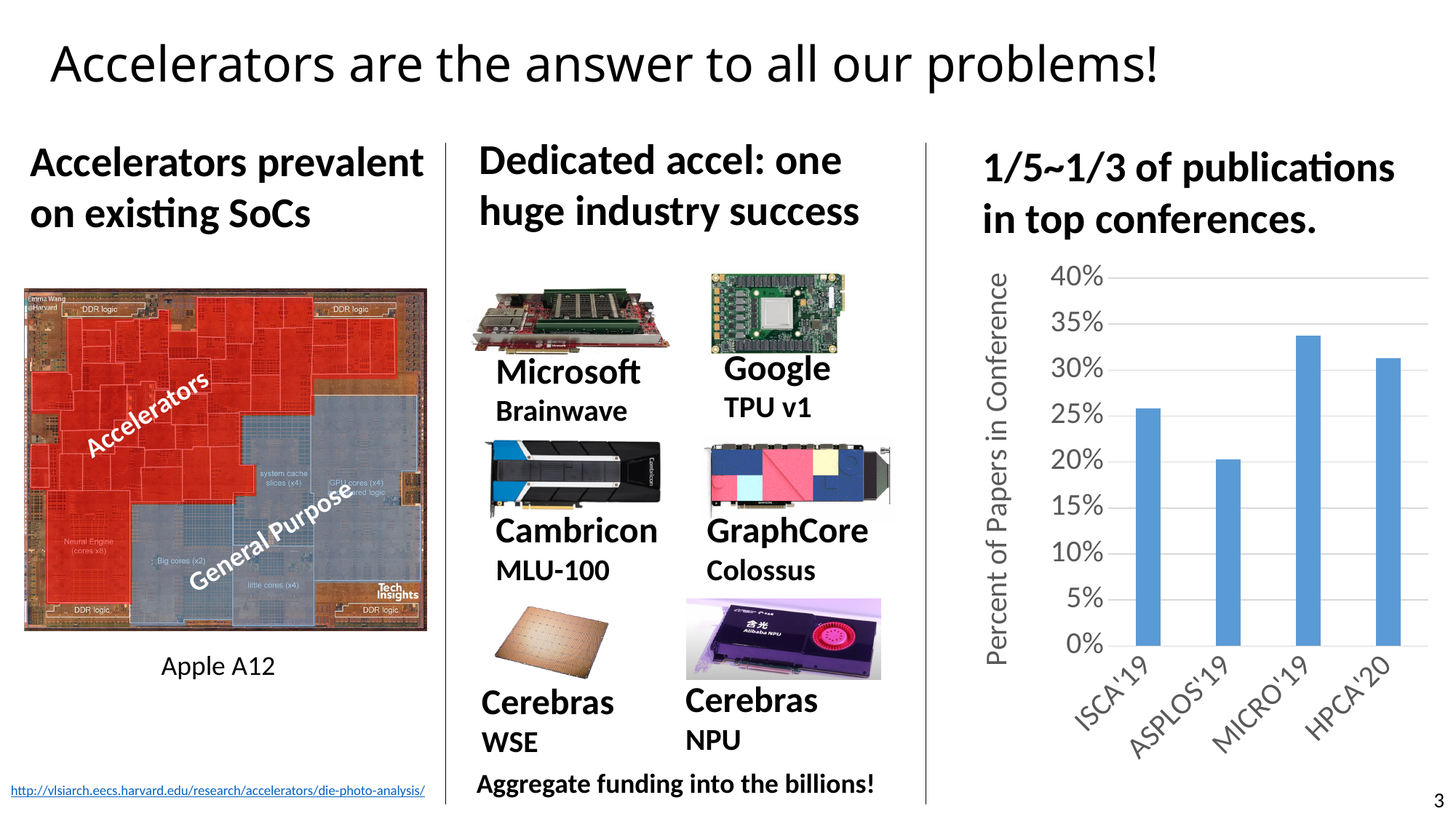
Is the value for MICRO'19 greater or less than 30%? greater Is the value for ISCA'19 greater or less than 30%? less Which conference has the highest percent of papers in the bar chart? MICRO'19 What is the highest value shown on the y axis of the bar chart? 40% What is the label of the y axis in the bar chart? Percent of Papers in Conference What kind of chart is shown on the right side of the slide? bar chart Which conference has the lowest percent of papers in the bar chart? ASPLOS'19 In the bar chart, which is larger: the value for MICRO'19 or HPCA'20? MICRO'19 In the bar chart, which is larger: the value for ISCA'19 or ASPLOS'19? ISCA'19 Is the value for ASPLOS'19 greater or less than 15%? greater How many conferences are shown on the x axis of the bar chart? 4